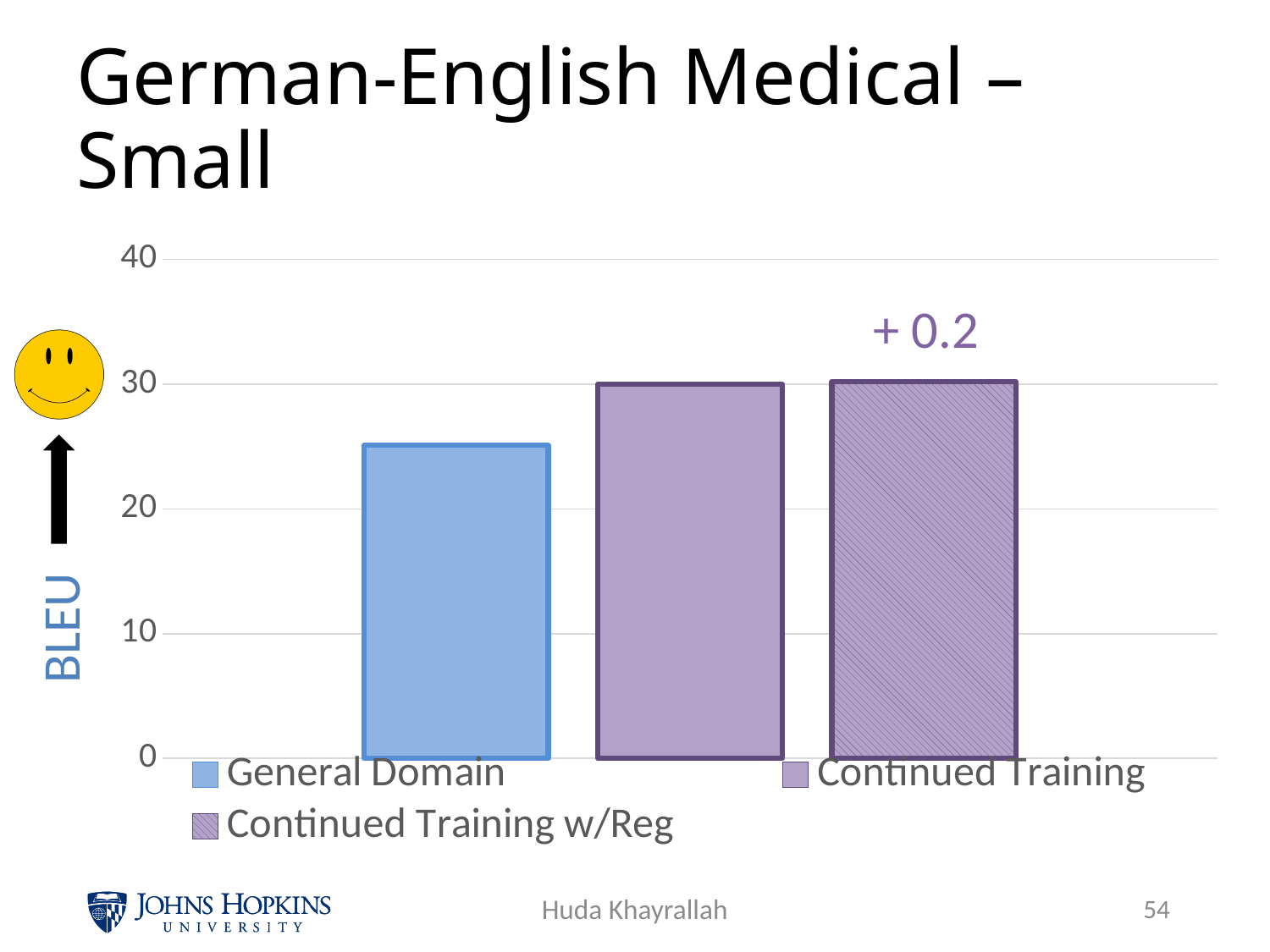
Is the value for Continued Training greater or less than 40? less Which series has the lowest BLEU score? General Domain Is the value for General Domain greater or less than 30? less Is the value for Continued Training w/Reg greater or less than 20? greater What kind of chart is shown on the slide? bar chart What is the label on the y axis of the chart? BLEU What annotation is printed above the Continued Training w/Reg bar? + 0.2 Which is larger, the BLEU score for General Domain or for Continued Training? Continued Training How many bars are plotted in the chart? 3 How many series does the legend list? 3